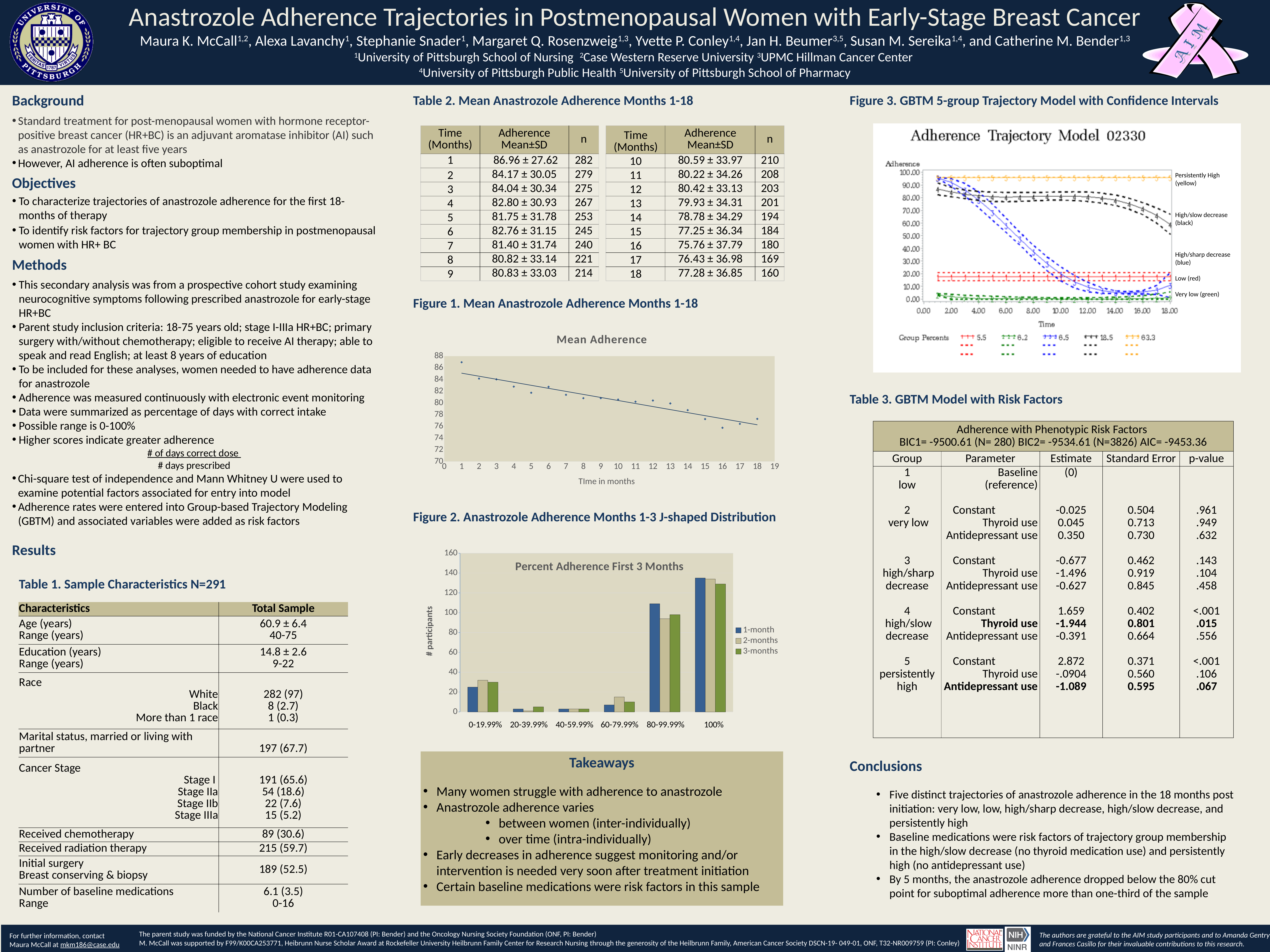
In Figure 2 (Percent Adherence First 3 Months), how many adherence categories are shown on the x axis? 6 In Figure 2 (Percent Adherence First 3 Months), how many series does the legend list? 3 In Figure 1 (Mean Adherence), do the values rise or fall as time in months increases? fall In Figure 2 (Percent Adherence First 3 Months), for the 80-99.99% category, which is larger: the 1-month bar or the 2-months bar? 1-month In Figure 3 (Adherence Trajectory Model), how many trajectory groups are plotted? 5 In Figure 2 (Percent Adherence First 3 Months), which adherence category has the highest number of participants? 100% In Figure 2 (Percent Adherence First 3 Months), is the 1-month value for the 80-99.99% category greater or less than 100? greater In Figure 1 (Mean Adherence), is the value at month 1 greater or less than 86? greater In Figure 3 (Adherence Trajectory Model), what is the group percent for the Persistently High (yellow) group? 63.3 In Figure 3 (Adherence Trajectory Model), which trajectory group has the largest group percent? Persistently High (yellow) What kind of chart is Figure 2 (Percent Adherence First 3 Months)? bar chart In Figure 2 (Percent Adherence First 3 Months), is the 1-month value for the 100% category greater or less than 120? greater